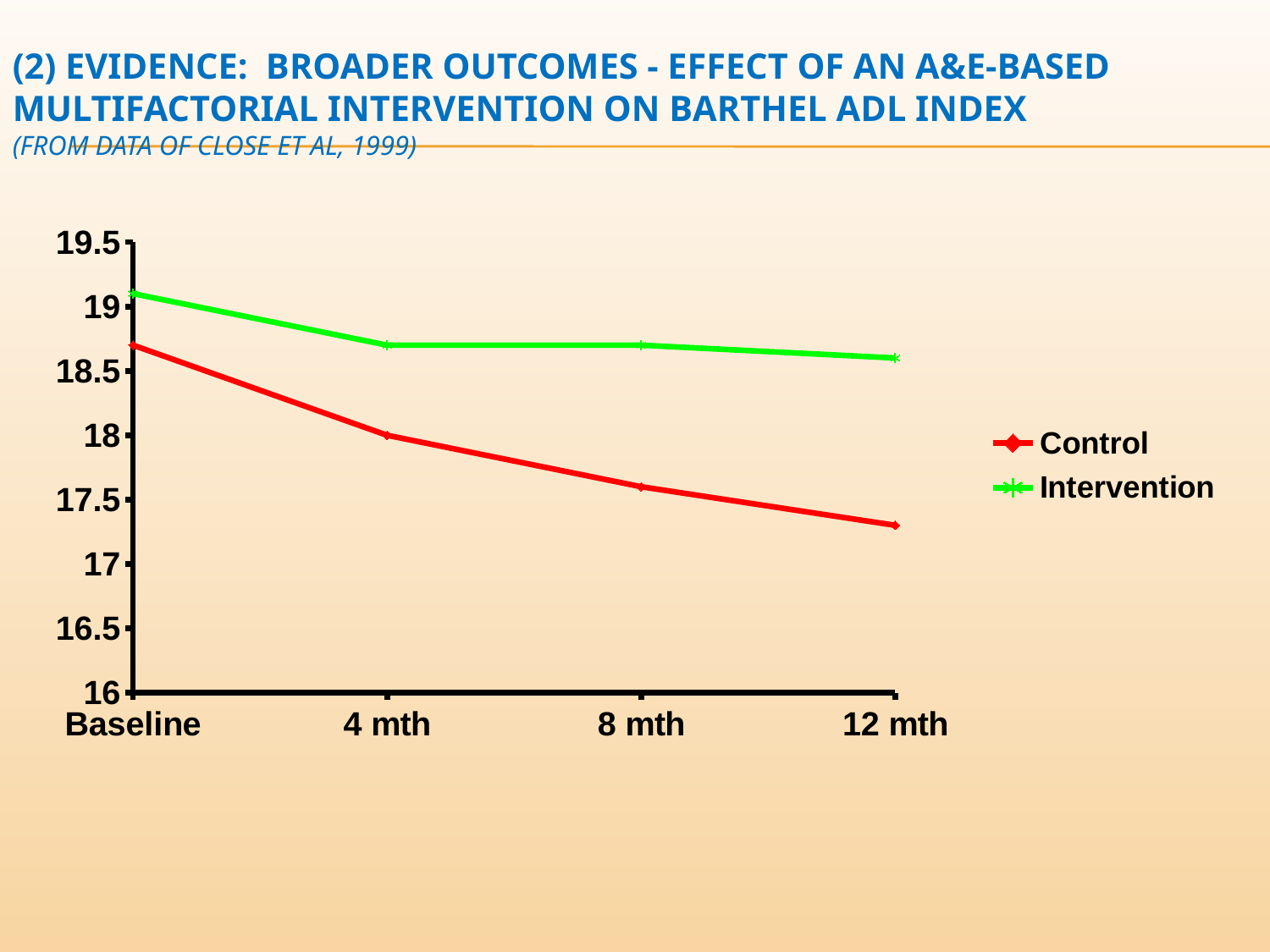
Does the Control line rise or fall from Baseline to 12 mth? fall At 12 mth, which series has the larger value, Control or Intervention? Intervention At which time point is the Intervention series highest? Baseline Is the value for Control at 12 mth greater or less than 17.5? less How many series does the legend list? 2 At which time point is the Control series highest? Baseline Is the value for Intervention at 4 mth greater or less than 18.5? greater What kind of chart is shown on the slide? line chart At which time point is the Control series lowest? 12 mth Which series is shown in red? Control How many time points are plotted along the x axis? 4 Is the value for Control at Baseline greater or less than 18.5? greater